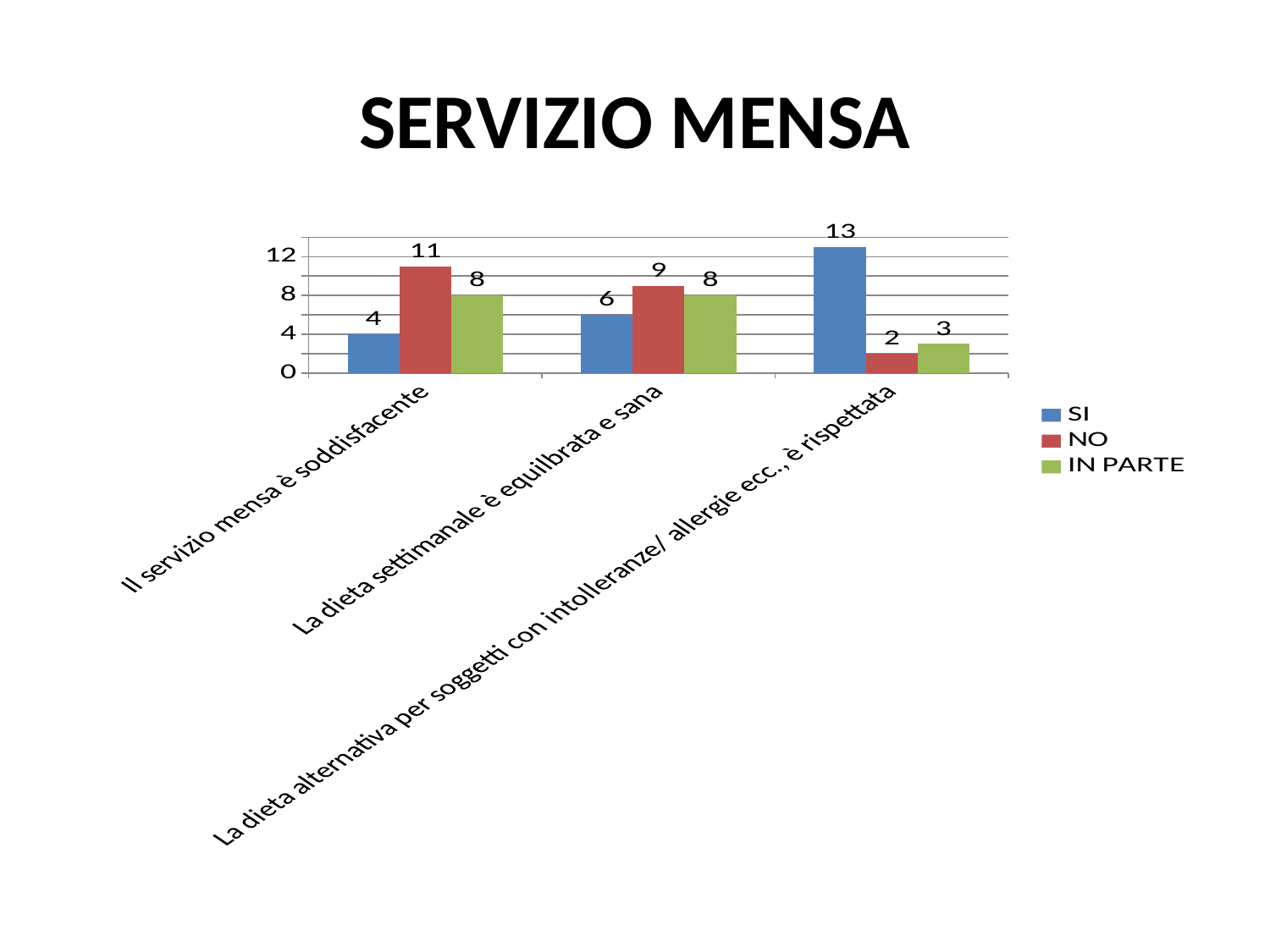
What kind of chart is shown on the slide? bar chart Is the SI value for "La dieta alternativa per soggetti con intolleranze/ allergie ecc., è rispettata" greater or less than 12? greater What is the SI value for "Il servizio mensa è soddisfacente"? 4 Which category has the highest SI value? La dieta alternativa per soggetti con intolleranze/ allergie ecc., è rispettata Which category has the lowest NO value? La dieta alternativa per soggetti con intolleranze/ allergie ecc., è rispettata What is the NO value for "La dieta settimanale è equilbrata e sana"? 9 How many series does the legend list? 3 For "La dieta settimanale è equilbrata e sana", which is larger: the NO value or the SI value? NO What is the title of the slide? SERVIZIO MENSA How many categories are shown on the x axis? 3 What is the difference between the NO and SI values for "Il servizio mensa è soddisfacente"? 7 What is the IN PARTE value for "La dieta alternativa per soggetti con intolleranze/ allergie ecc., è rispettata"? 3